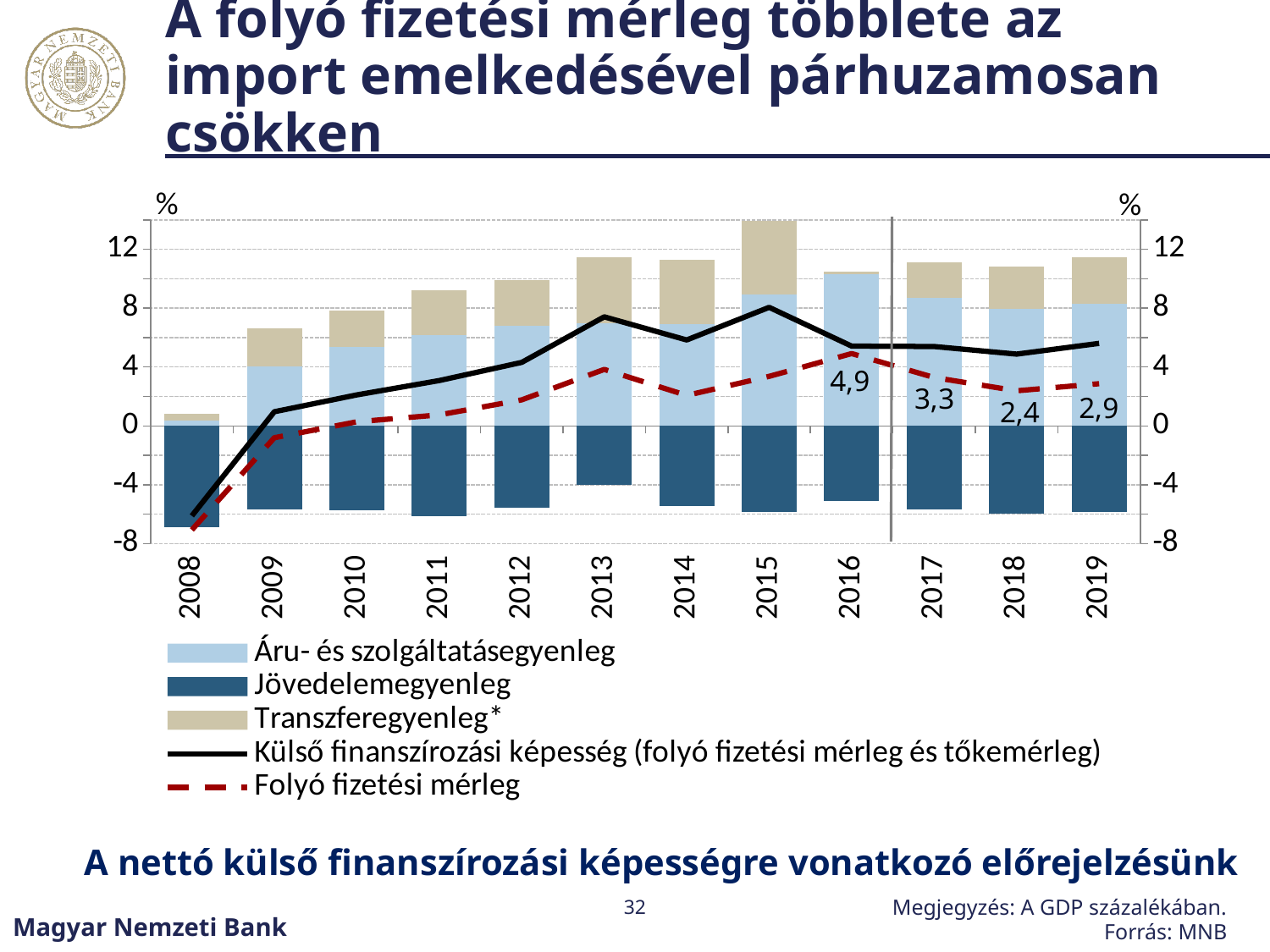
What is the value of Folyó fizetési mérleg in 2018? 2,4 What is the value of Folyó fizetési mérleg in 2016? 4,9 What is the difference between the Folyó fizetési mérleg values for 2016 and 2017? 1,6 Which year has the larger Folyó fizetési mérleg value, 2017 or 2018? 2017 What is the value of Folyó fizetési mérleg in 2019? 2,9 Is the Jövedelemegyenleg value for 2008 greater or less than -4? less Among the years with printed data labels (2016–2019), which year has the lowest Folyó fizetési mérleg value? 2018 What is the value of Folyó fizetési mérleg in 2017? 3,3 How many series does the legend list? 5 What kind of chart is shown on the slide? Combined stacked bar and line chart How many years are shown on the x axis? 12 Does the Folyó fizetési mérleg line rise or fall from 2008 to 2013? rise